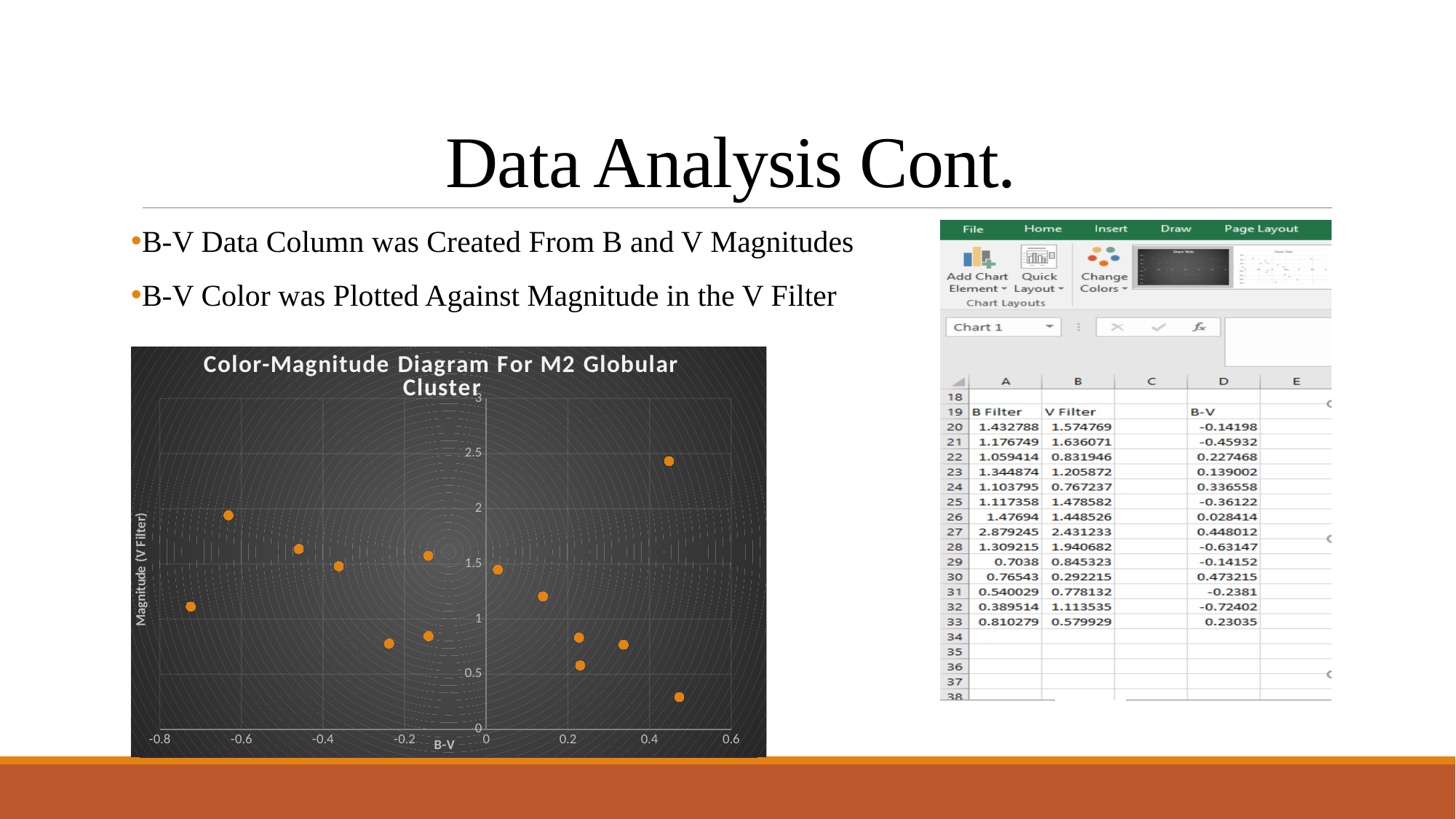
What is the title of the chart on the slide? Color-Magnitude Diagram For M2 Globular Cluster Is the highest plotted magnitude value on the chart greater or less than 2? greater Is the B-V value of the leftmost point on the chart greater or less than -0.6? less Is the lowest plotted magnitude value on the chart greater or less than 0.5? less What kind of chart is shown on the slide? Scatter chart What is the maximum value shown on the vertical axis of the chart? 3 What is the label of the vertical axis of the chart? Magnitude (V Filter) How many data points are plotted on the chart? 14 What is the minimum value shown on the horizontal axis of the chart? -0.8 Which has the higher magnitude: the point near B-V 0.44 or the point near B-V 0.47? The point near B-V 0.44